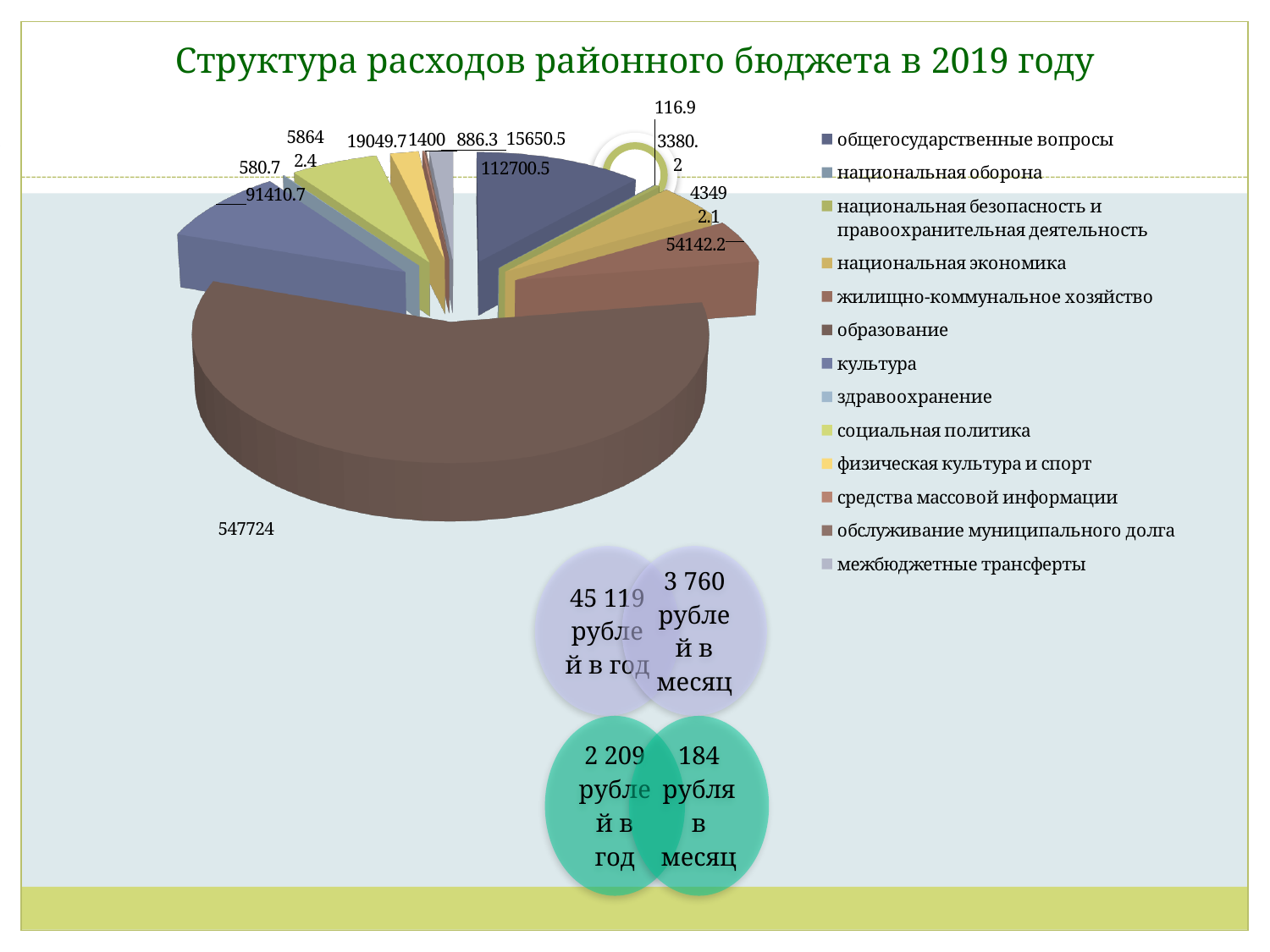
What kind of chart is shown on the slide? pie chart What is the value shown for общегосударственные вопросы? 112700.5 What is the value shown for образование? 547724 What is the value shown for культура? 91410.7 What is the value shown for жилищно-коммунальное хозяйство? 54142.2 Which is larger, the value for образование or the value for общегосударственные вопросы? образование What is the difference between the value for образование and the value for общегосударственные вопросы? 435023.5 What is the smallest data label value shown on the pie chart? 116.9 What is the title of the chart? Структура расходов районного бюджета в 2019 году Which is larger, the value for культура or the value for жилищно-коммунальное хозяйство? культура Which category has the largest slice of the pie chart? образование How many categories does the legend of the pie chart list? 13